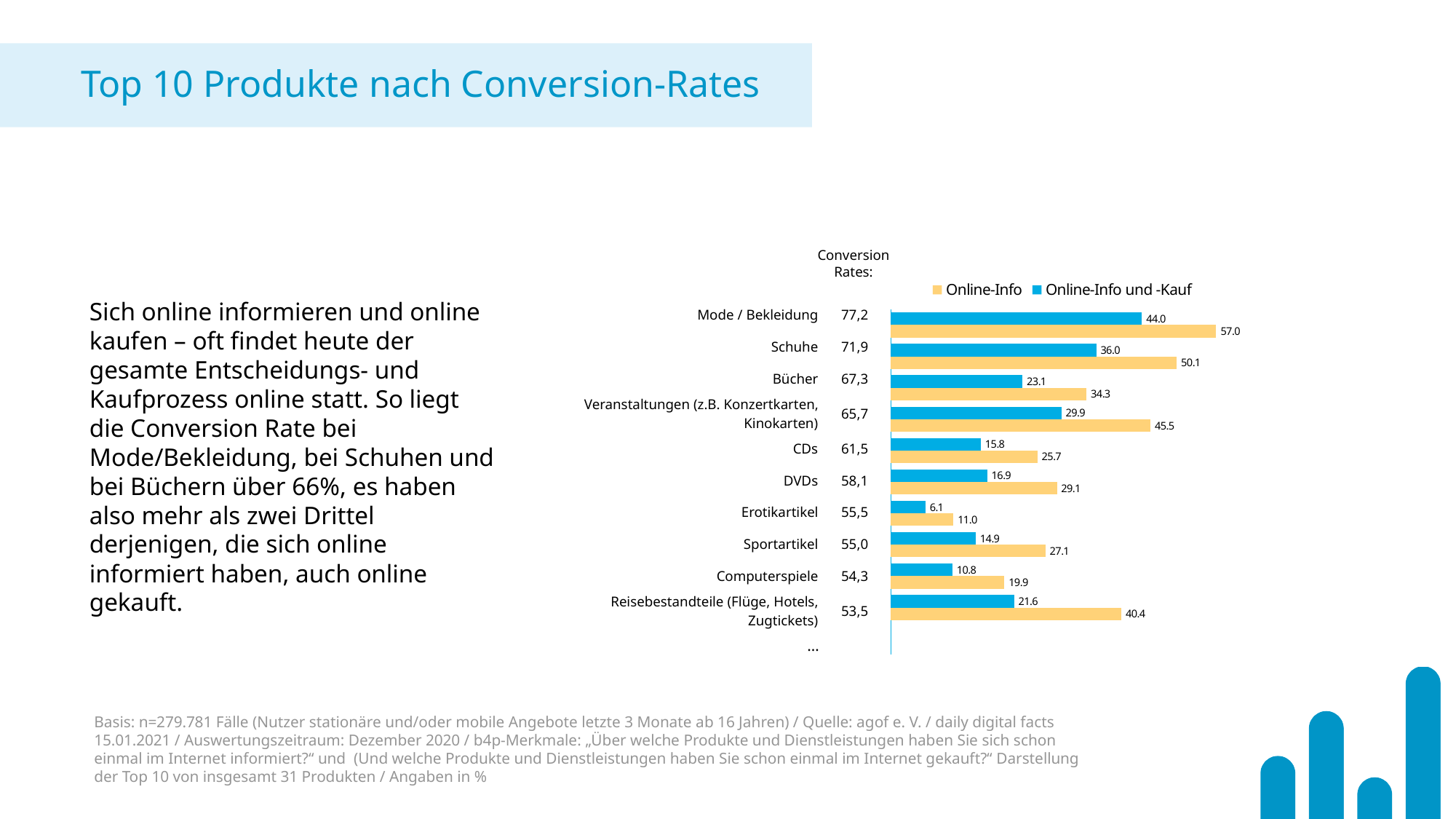
What kind of chart is shown on the slide? Bar chart What is the Online-Info und -Kauf value for Reisebestandteile (Flüge, Hotels, Zugtickets)? 21.6 Which product has the lowest Online-Info und -Kauf value? Erotikartikel For Mode / Bekleidung, what is the difference between the Online-Info value and the Online-Info und -Kauf value? 13.0 How many series does the chart legend list? 2 What is the Online-Info value for Schuhe? 50.1 Which product has the highest Online-Info value? Mode / Bekleidung Which has the larger Online-Info value: Veranstaltungen (z.B. Konzertkarten, Kinokarten) or Reisebestandteile (Flüge, Hotels, Zugtickets)? Veranstaltungen (z.B. Konzertkarten, Kinokarten) What is the Online-Info und -Kauf value for Bücher? 23.1 What is the difference between the Online-Info value for Schuhe and the Online-Info value for Bücher? 15.8 What conversion rate is shown next to Mode / Bekleidung? 77,2 How many named products have bars plotted in the chart? 10